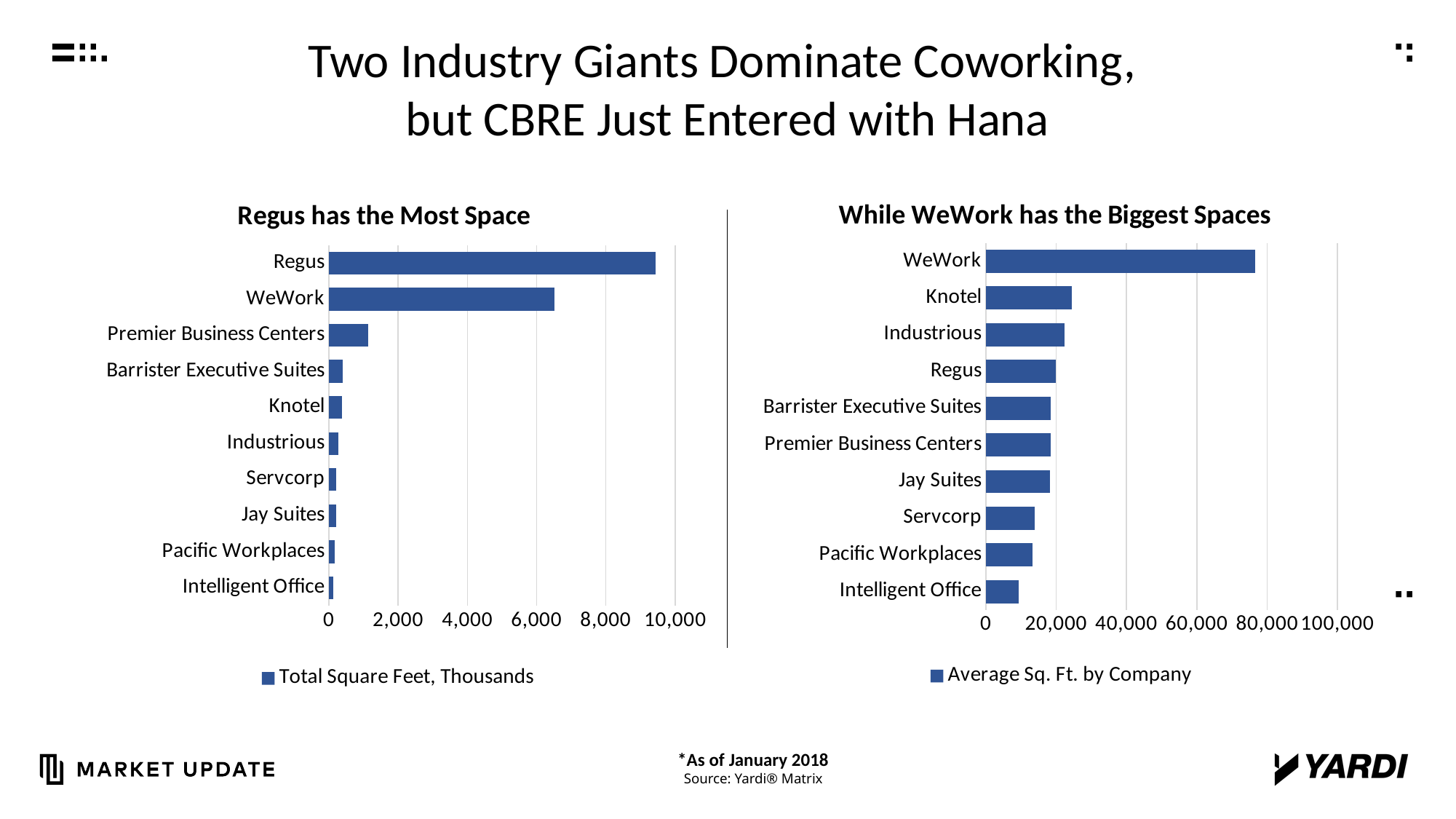
In the chart titled "Regus has the Most Space", what kind of chart is shown? bar chart In the chart titled "While WeWork has the Biggest Spaces", is the value for WeWork greater or less than 60,000? greater In the chart titled "Regus has the Most Space", is the value for WeWork greater or less than 6,000? greater In the chart titled "While WeWork has the Biggest Spaces", which company has the lowest value? Intelligent Office In the chart titled "While WeWork has the Biggest Spaces", which company has the highest value? WeWork In the chart titled "While WeWork has the Biggest Spaces", which is larger, the value for Knotel or the value for Servcorp? Knotel In the chart titled "Regus has the Most Space", what series does the legend list? Total Square Feet, Thousands In the chart titled "Regus has the Most Space", how many companies are plotted? 10 In the chart titled "Regus has the Most Space", is the value for Premier Business Centers greater or less than 2,000? less In the chart titled "Regus has the Most Space", which company has the lowest value? Intelligent Office In the chart titled "While WeWork has the Biggest Spaces", how many series does the legend list? 1 In the chart titled "Regus has the Most Space", which company has the highest value? Regus